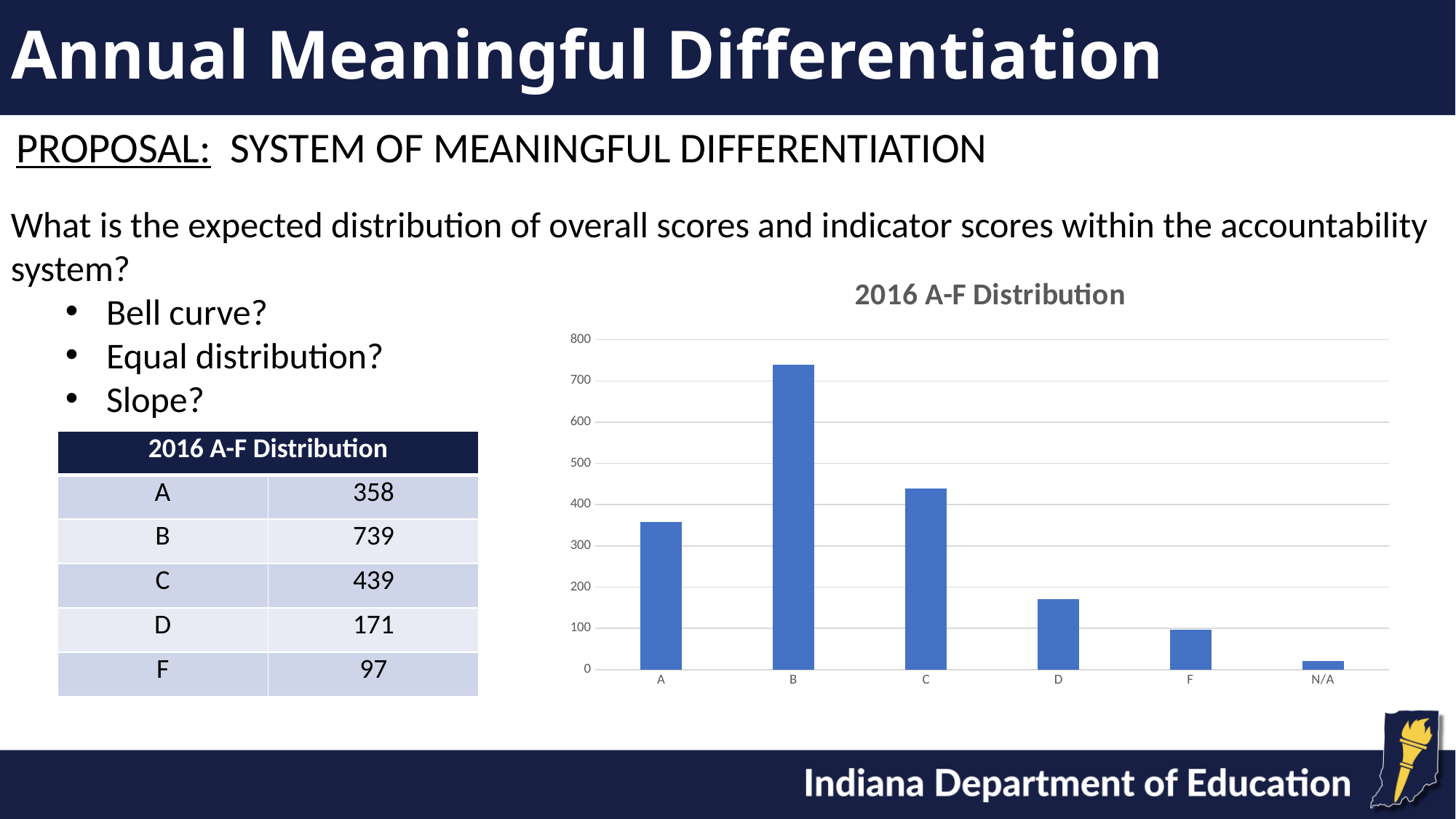
According to the slide, what is the 2016 A-F Distribution value for B? 739 Which category has the lowest bar in the 2016 A-F Distribution chart? N/A Which category has the highest bar in the 2016 A-F Distribution chart? B Is the value for B in the 2016 A-F Distribution chart greater or less than 700? greater What type of chart is the 2016 A-F Distribution chart? bar chart According to the slide, what is the 2016 A-F Distribution value for D? 171 What is the difference between the values for B and C in the 2016 A-F Distribution? 300 What is the title of the chart on the slide? 2016 A-F Distribution According to the slide, what is the 2016 A-F Distribution value for F? 97 Which is larger in the 2016 A-F Distribution chart, the bar for A or the bar for C? C Is the value for N/A in the 2016 A-F Distribution chart greater or less than 100? less How many categories are shown on the x axis of the 2016 A-F Distribution chart? 6